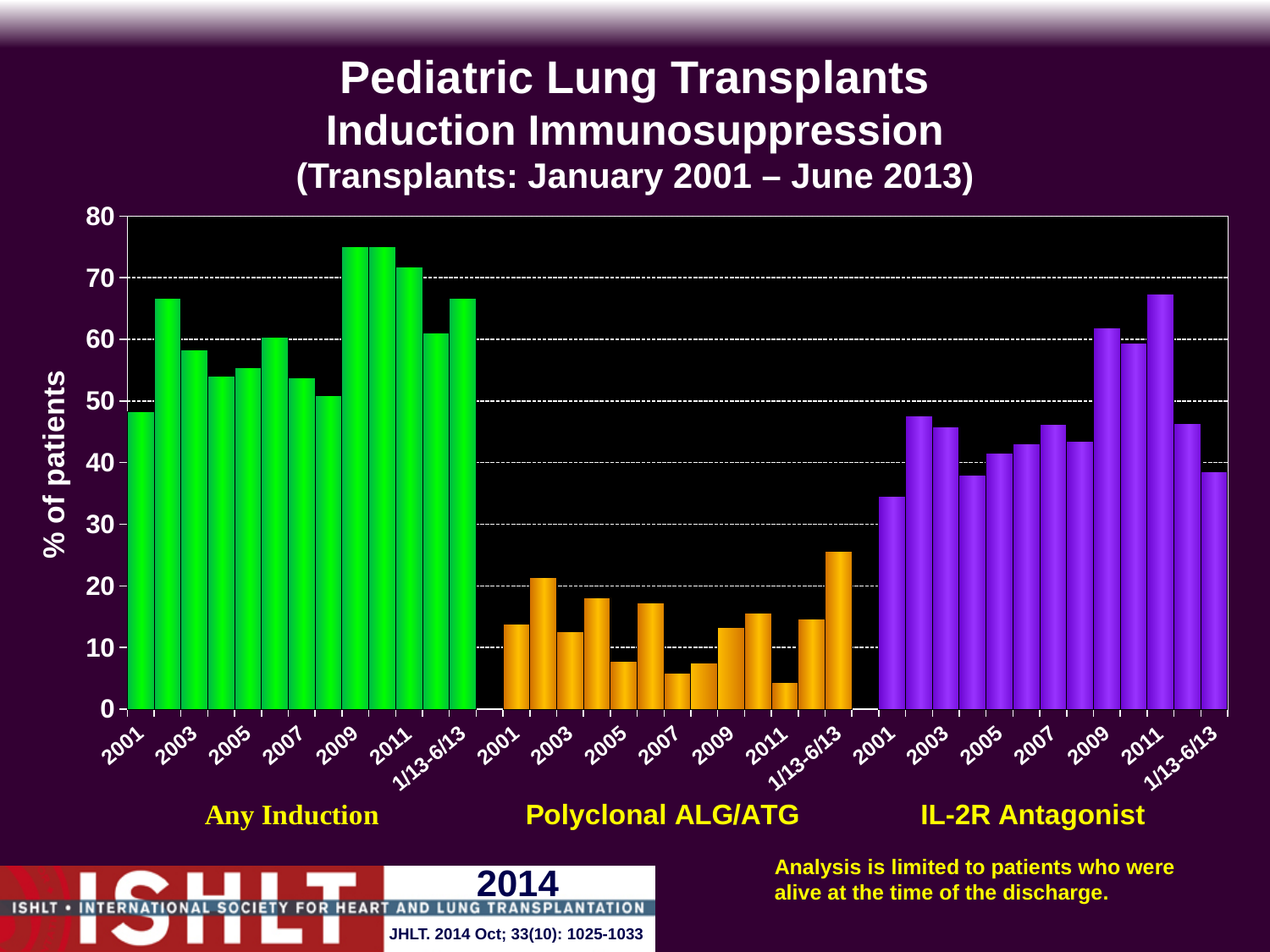
Which year has the highest value in the Polyclonal ALG/ATG group? 1/13-6/13 Is the value for 2009 in the IL-2R Antagonist group greater or less than 60? greater In the Any Induction group, which is larger, the value for 2002 or the value for 2003? 2002 What is the label of the y axis? % of patients Is the value for 2002 in the Polyclonal ALG/ATG group greater or less than 20? greater Which year has the highest value in the IL-2R Antagonist group? 2011 What kind of chart is shown on the slide? bar chart How many bars are plotted in the Any Induction group? 13 Which year has the lowest value in the IL-2R Antagonist group? 2001 Is the value for 2001 in the Any Induction group greater or less than 50? less How many induction groups are shown along the x axis? 3 Which year has the lowest value in the Polyclonal ALG/ATG group? 2011